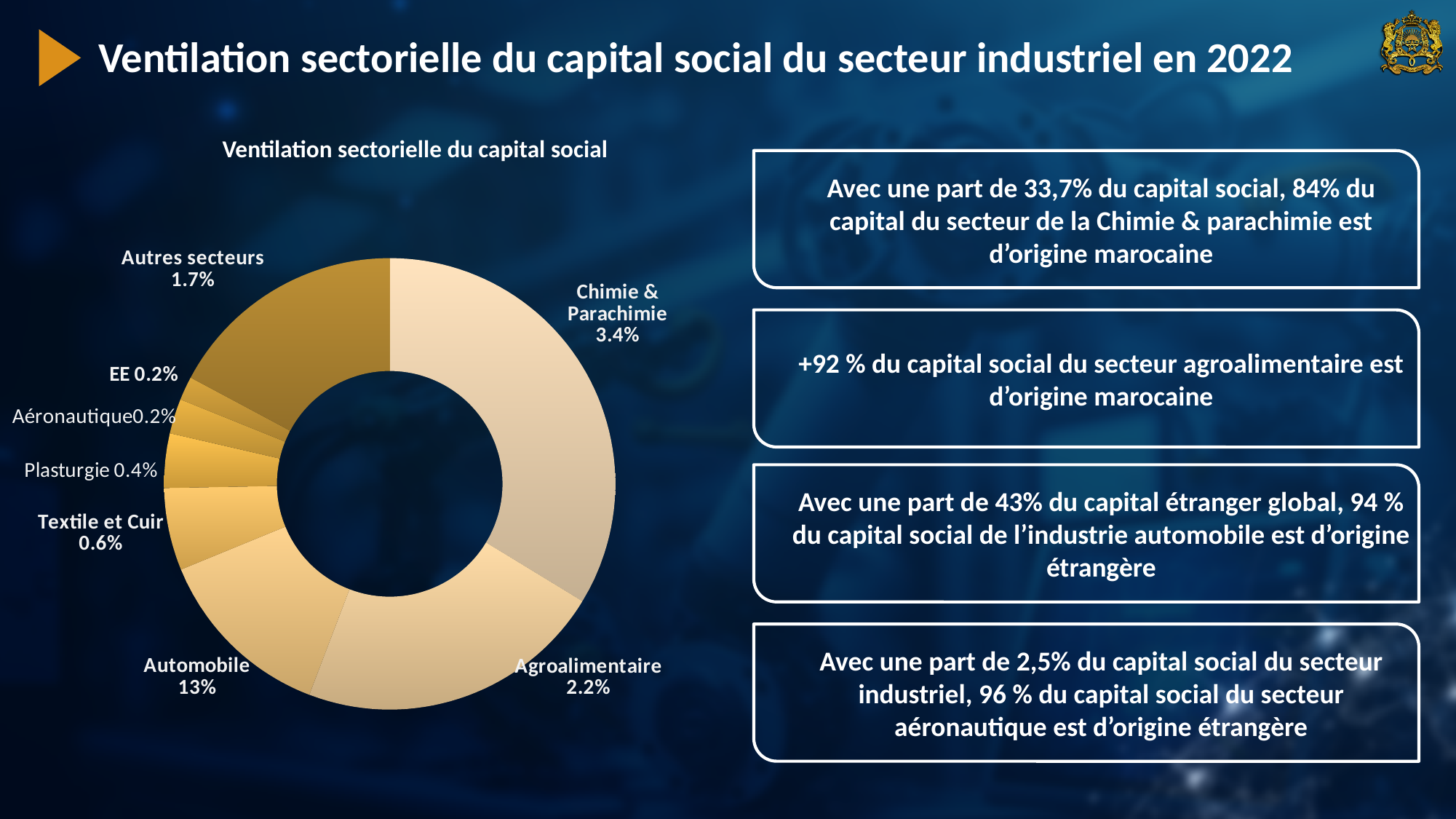
What type of chart is shown on the slide? Doughnut (pie) chart What value is labelled for Plasturgie in the chart? 0.4% How many sectors (slices) are labelled in the chart? 8 What value is labelled for Agroalimentaire in the chart? 2.2% What value is labelled for Aéronautique in the chart? 0.2% What value is labelled for Chimie & Parachimie in the chart? 3.4% What value is labelled for Automobile in the chart? 13% What is the difference between the labelled values for Textile et Cuir and Plasturgie? 0.2% What is the title of the chart? Ventilation sectorielle du capital social What value is labelled for Autres secteurs in the chart? 1.7% What value is labelled for Textile et Cuir in the chart? 0.6% Which has the larger labelled value, Textile et Cuir or Plasturgie? Textile et Cuir